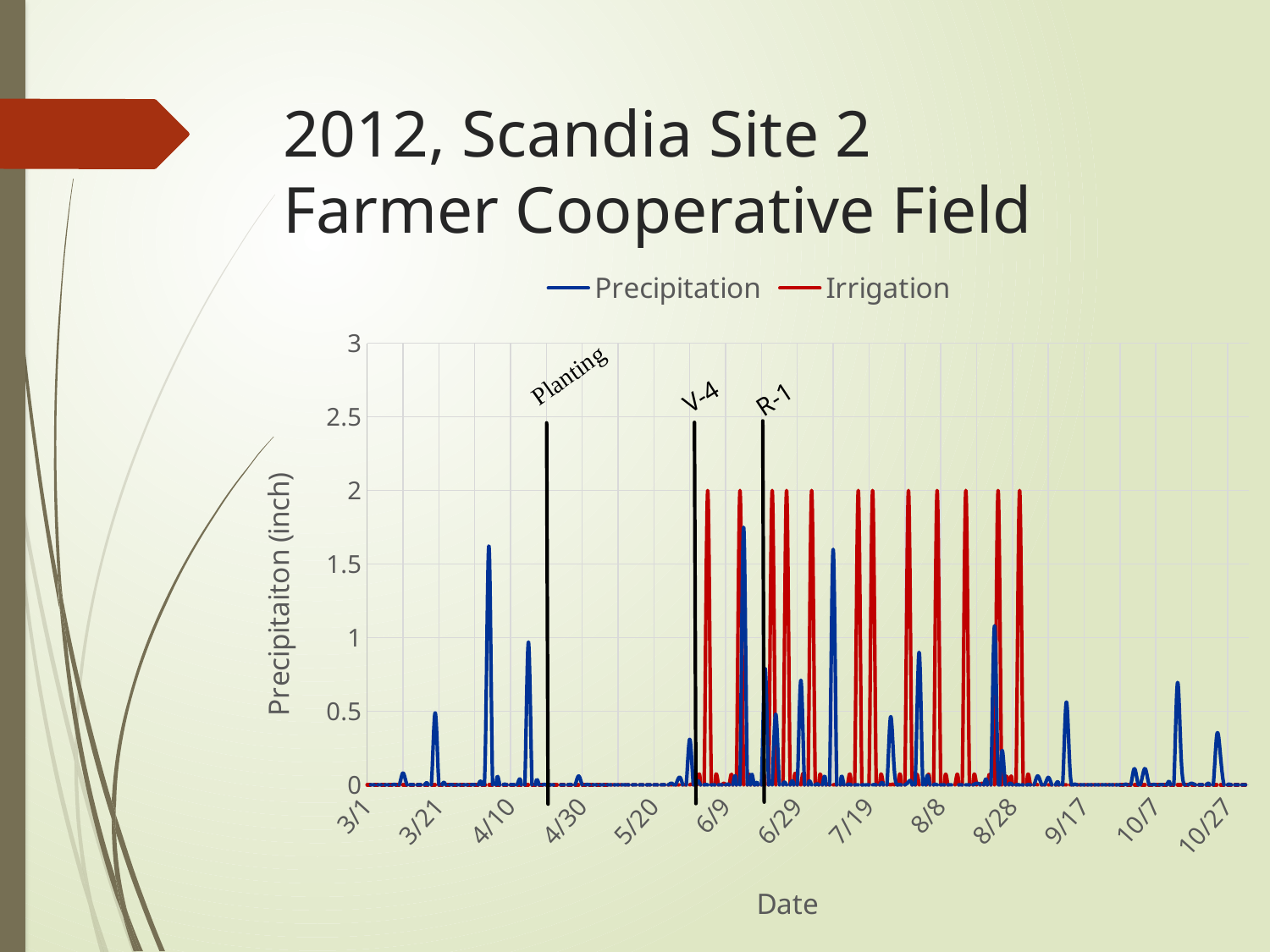
What are the two series named in the legend? Precipitation and Irrigation Is the Irrigation peak value greater or less than 1.5? greater What are the three labels on the vertical marker lines in the chart? Planting, V-4, R-1 How many series does the legend list? 2 How many date labels are shown along the x axis? 13 What kind of chart is shown on the slide? line chart What is the highest value shown on the y axis? 3 Is the Precipitation peak near 3/21 greater or less than 1? less What value do the Irrigation peaks reach on the y axis? 2 Is the highest Precipitation peak greater or less than 2? less Which series reaches a higher peak value, Precipitation or Irrigation? Irrigation